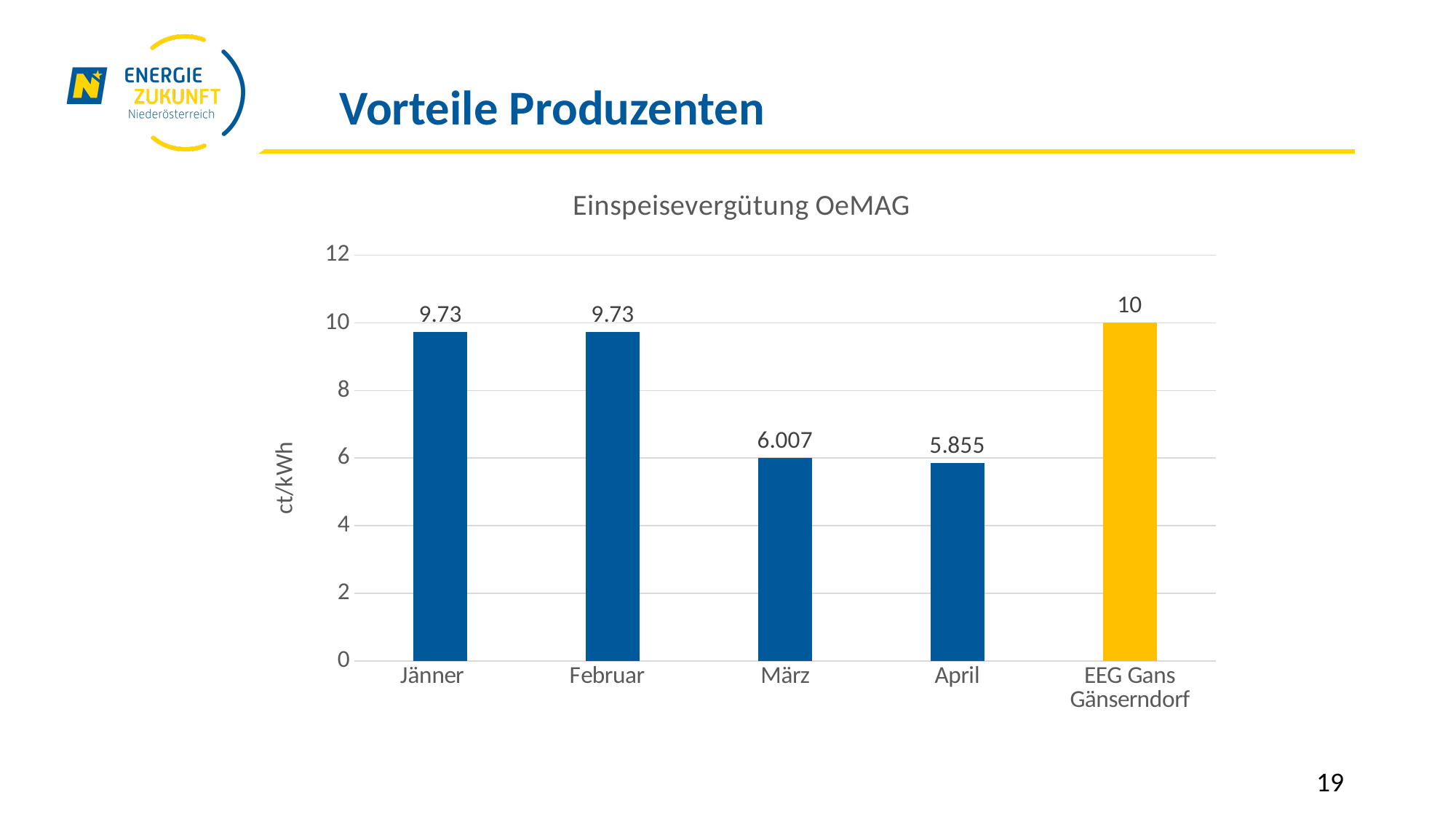
What is the difference between the values for Februar and März? 3.723 What is the value for April? 5.855 Which is larger, the value for März or the value for April? März What is the value for März? 6.007 What is the value for Jänner? 9.73 Which category has the lowest value? April What kind of chart is this? Bar chart What is the value for EEG Gans Gänserndorf? 10 How many categories are shown on the x axis? 5 What is the title of the chart? Einspeisevergütung OeMAG What is the difference between the values for EEG Gans Gänserndorf and April? 4.145 Which category has the highest value? EEG Gans Gänserndorf